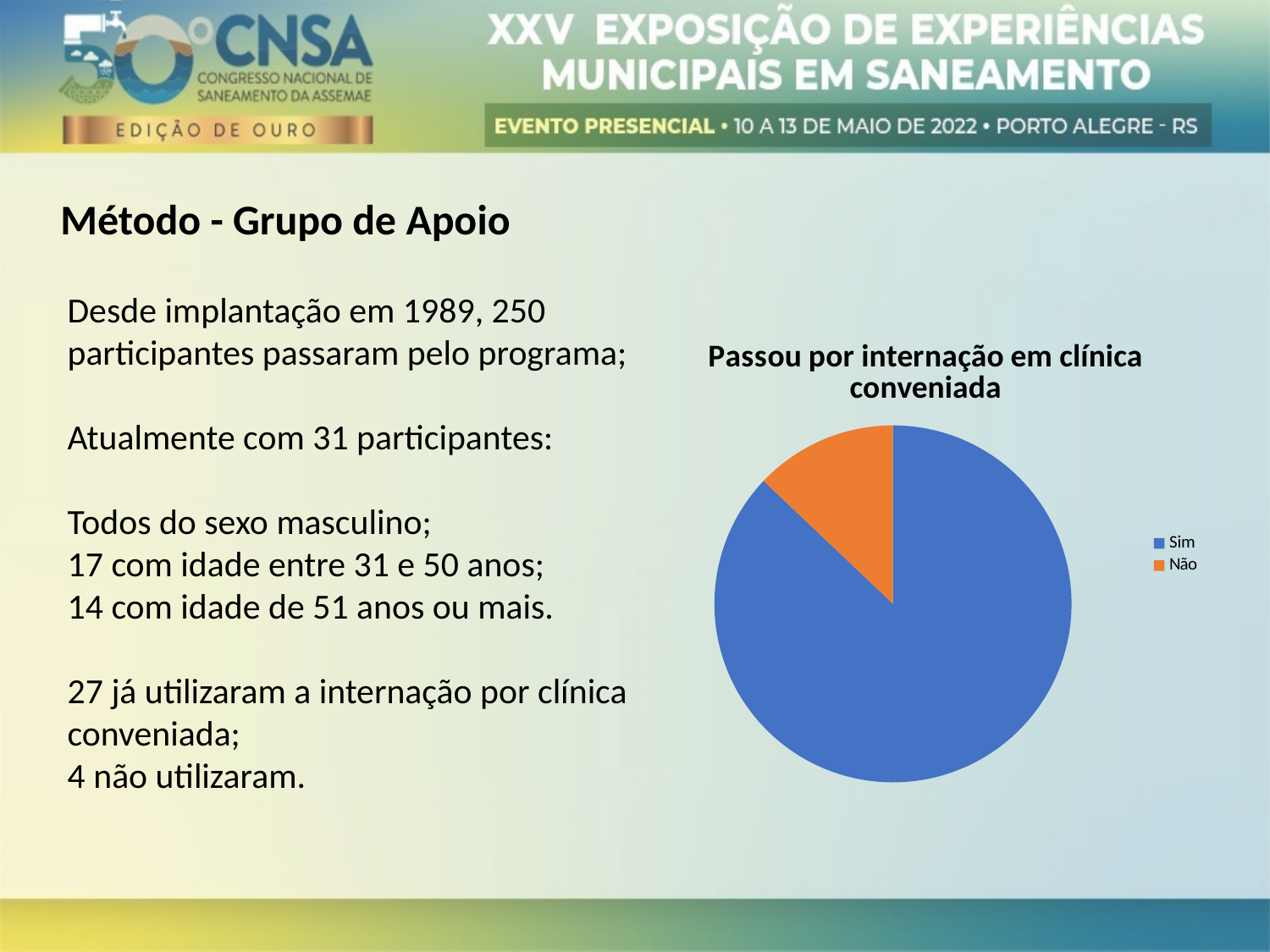
How many slices does the pie chart have? 2 Which slice is larger in the pie chart, Sim or Não? Sim Which category has the largest slice in the pie chart? Sim Which category has the smallest slice in the pie chart? Não What is the title of the pie chart? Passou por internação em clínica conveniada What kind of chart is shown on the slide? pie chart How many entries does the legend of the pie chart list? 2 Does the Sim slice take up more or less than half of the pie chart? more What colour is the Não slice in the pie chart? orange